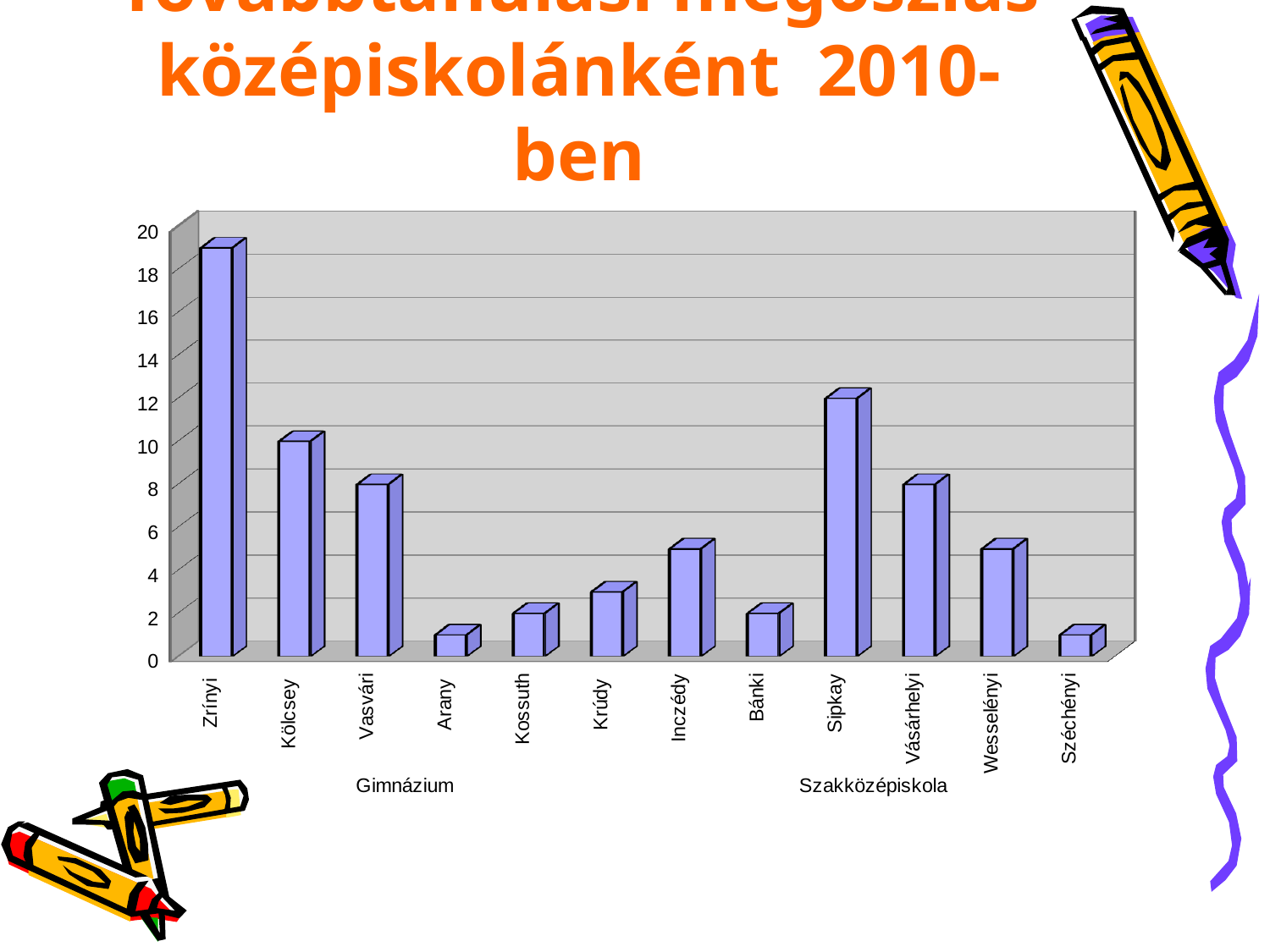
What kind of chart is shown on the slide? bar chart Which is larger, the value for Krúdy or the value for Wesselényi? Wesselényi Is the value for Sipkay greater or less than 10? greater Is the value for Arany greater or less than 2? less Is the value for Zrínyi greater or less than 18? greater Which is larger, the value for Kölcsey or the value for Sipkay? Sipkay Which school has the highest bar among the Szakközépiskola group? Sipkay Which school has the highest bar in the chart? Zrínyi What are the two group labels shown below the school names on the x axis? Gimnázium and Szakközépiskola How many schools (categories) are shown on the x axis of the chart? 12